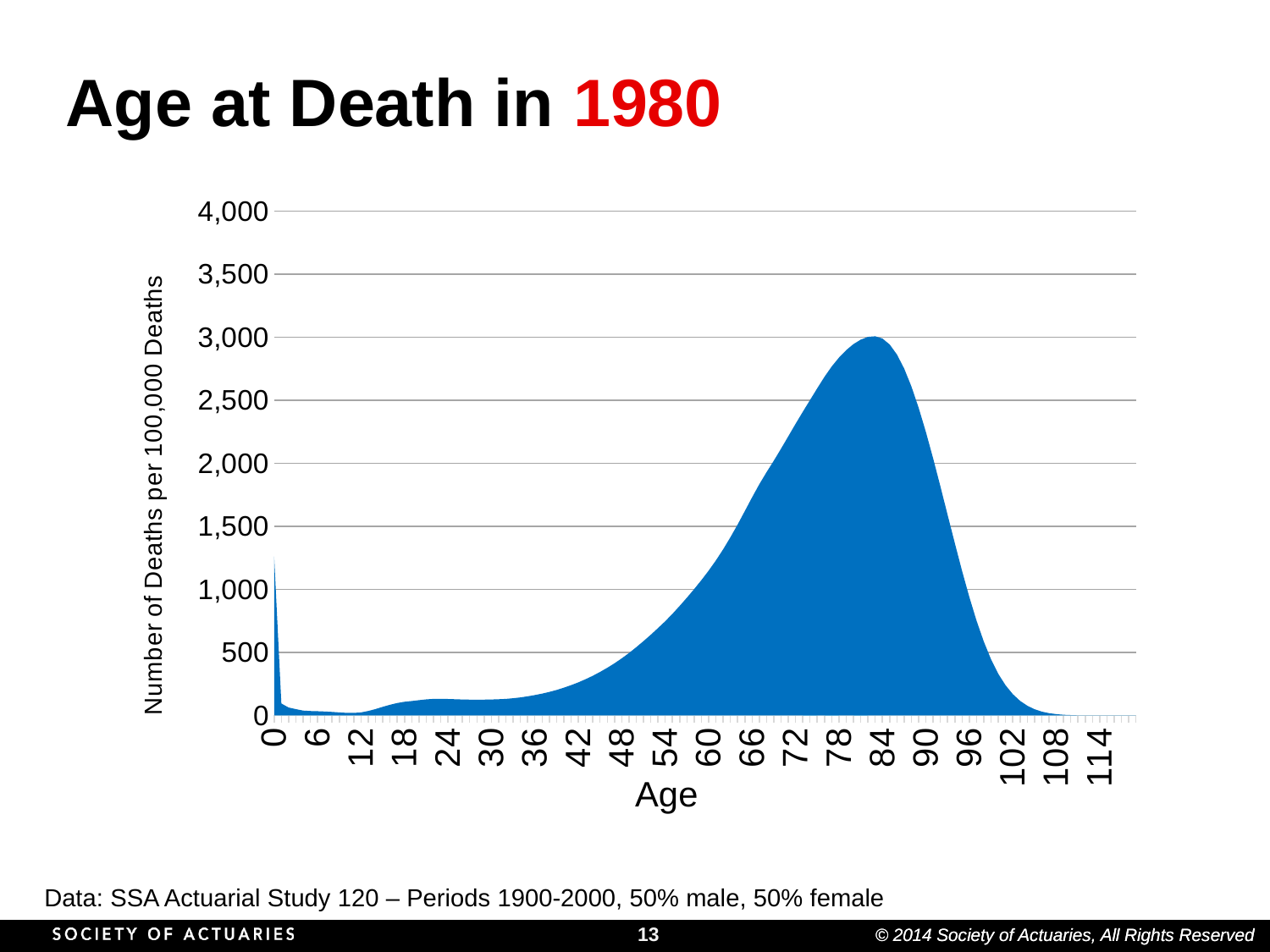
Which is larger, the value at age 72 or the value at age 48? Age 72 What kind of chart is shown on the slide? Area chart Is the value at age 0 greater or less than 1,000? greater What is the title of the chart on the slide? Age at Death in 1980 Do the values rise or fall as age increases from 84 to 108? Fall Do the values rise or fall as age increases from 48 to 78? Rise Is the value at age 72 greater or less than 2,000? greater What is the label of the vertical axis? Number of Deaths per 100,000 Deaths Is the value at age 30 greater or less than 500? less